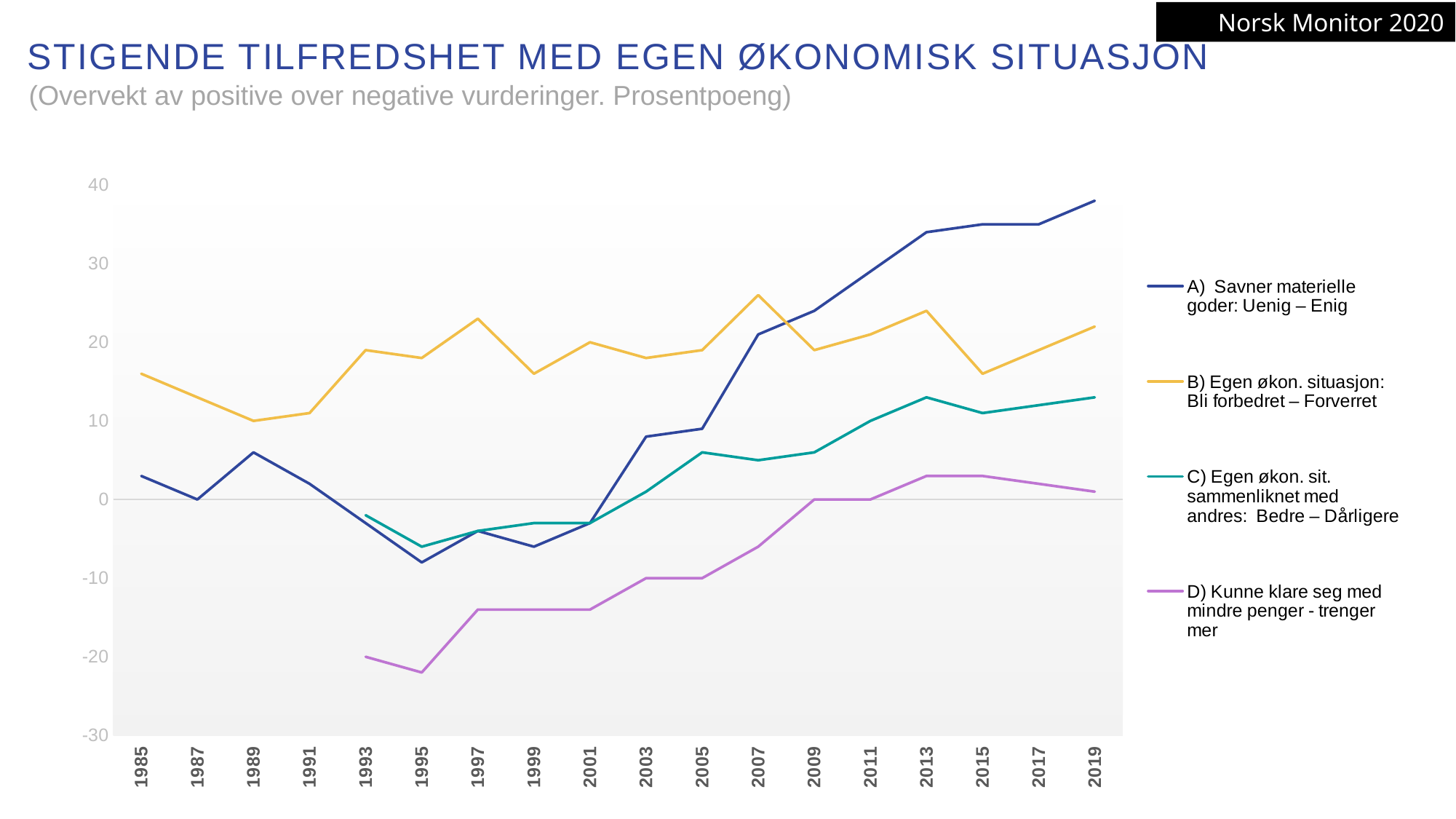
In 2013, which is larger: series A (Savner materielle goder) or series B (Egen økon. situasjon)? Series A (Savner materielle goder) In 2007, which is larger: series A (Savner materielle goder) or series B (Egen økon. situasjon)? Series B (Egen økon. situasjon) What is the title of the chart on the slide? STIGENDE TILFREDSHET MED EGEN ØKONOMISK SITUASJON Does series A (Savner materielle goder) rise or fall from 2001 to 2019? Rises How many series does the legend list? 4 Is the value for series B (Egen økon. situasjon) in 1997 greater or less than 20? greater Which series has the lowest value in 2019? D) Kunne klare seg med mindre penger - trenger mer Which series has the highest value in 2019? A) Savner materielle goder: Uenig – Enig How many years are labelled on the x axis? 18 Is the value for series A (Savner materielle goder) in 2019 greater or less than 30? greater What kind of chart is shown on the slide? Line chart Is the value for series D (Kunne klare seg med mindre penger) in 1995 greater or less than -20? less